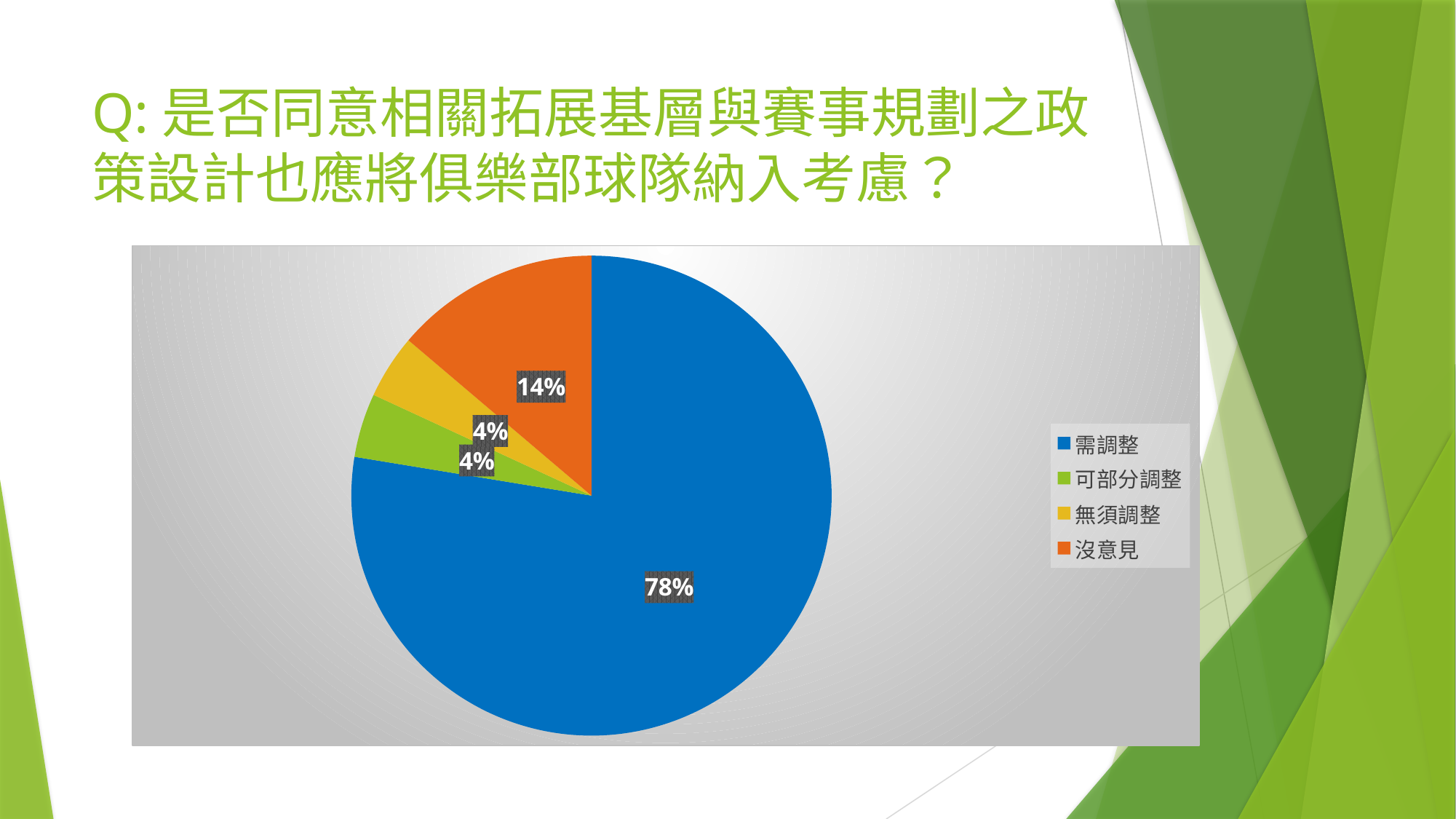
What is the combined share of 可部分調整 and 無須調整? 8% What share of the pie does 需調整 have? 78% Which is larger, the share of 沒意見 or the share of 無須調整? 沒意見 Which category has the largest slice of the pie? 需調整 What kind of chart is shown on the slide? pie chart What is the difference between the shares of 需調整 and 沒意見? 64% Which colour represents 沒意見 in the pie chart? orange How many categories does the pie chart show? 4 How many entries does the legend list? 4 What share of the pie does 無須調整 have? 4% What share of the pie does 沒意見 have? 14% What share of the pie does 可部分調整 have? 4%